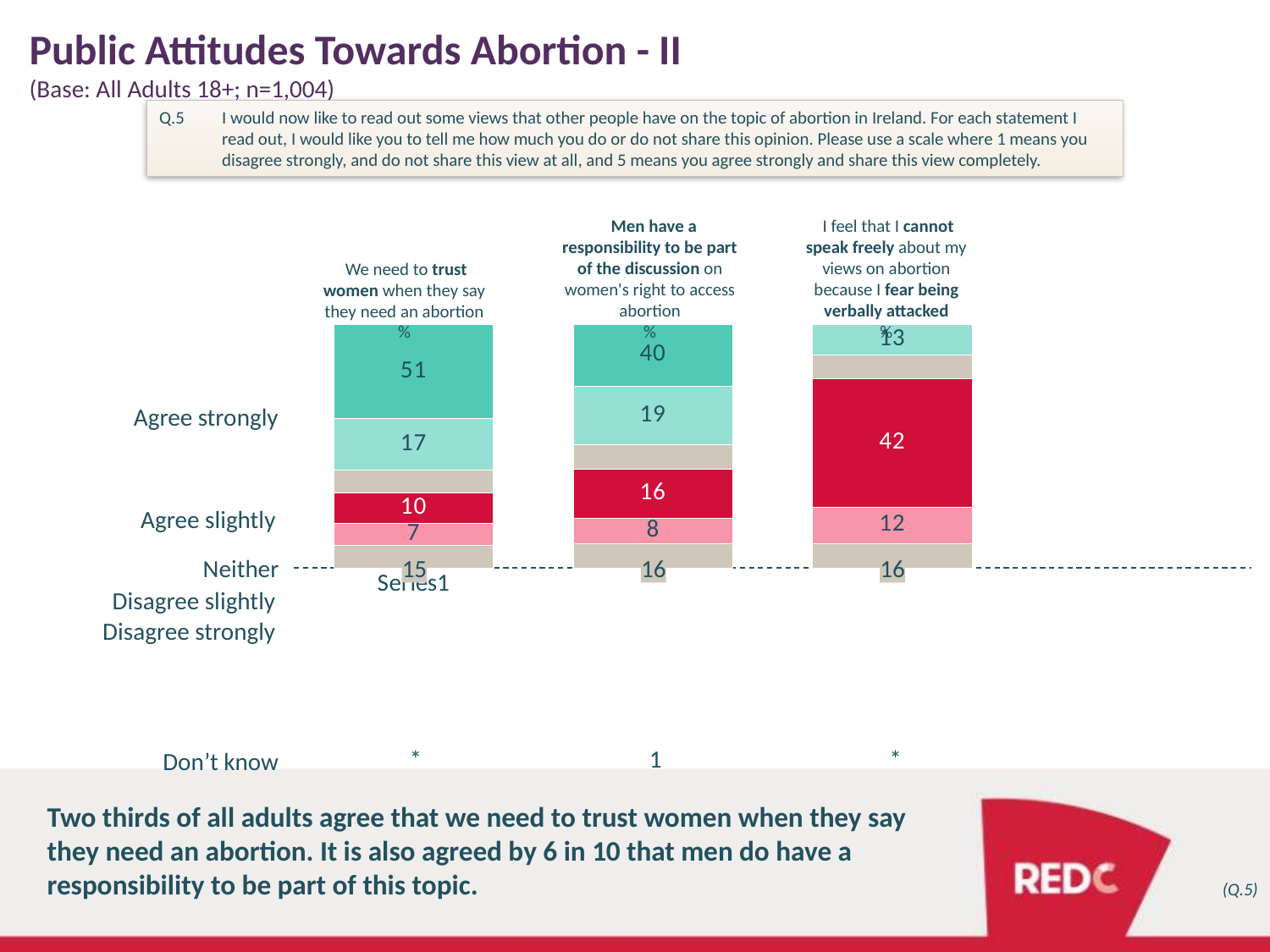
What percentage agree strongly that we need to trust women when they say they need an abortion? 51 Which statement has the largest red segment? I feel that I cannot speak freely about my views on abortion because I fear being verbally attacked Which statement has the largest 'Agree strongly' (dark teal) segment? We need to trust women when they say they need an abortion What is the value of the pink segment in the bar for 'We need to trust women when they say they need an abortion'? 7 What is the 'Don't know' value for the statement 'Men have a responsibility to be part of the discussion'? 1 What is the difference between the 'Agree strongly' values for 'We need to trust women' (51) and 'Men have a responsibility to be part of the discussion' (40)? 11 What type of chart is shown on the slide? Stacked bar chart What is the value of the light teal (agree slightly) segment in the bar for 'Men have a responsibility to be part of the discussion'? 19 What percentage agree strongly that men have a responsibility to be part of the discussion on women's right to access abortion? 40 Is the red segment larger for 'Men have a responsibility to be part of the discussion' or for 'We need to trust women when they say they need an abortion'? Men have a responsibility to be part of the discussion How many statements (bars) are shown in the chart? 3 What is the value of the red segment in the bar for 'I feel that I cannot speak freely about my views on abortion because I fear being verbally attacked'? 42